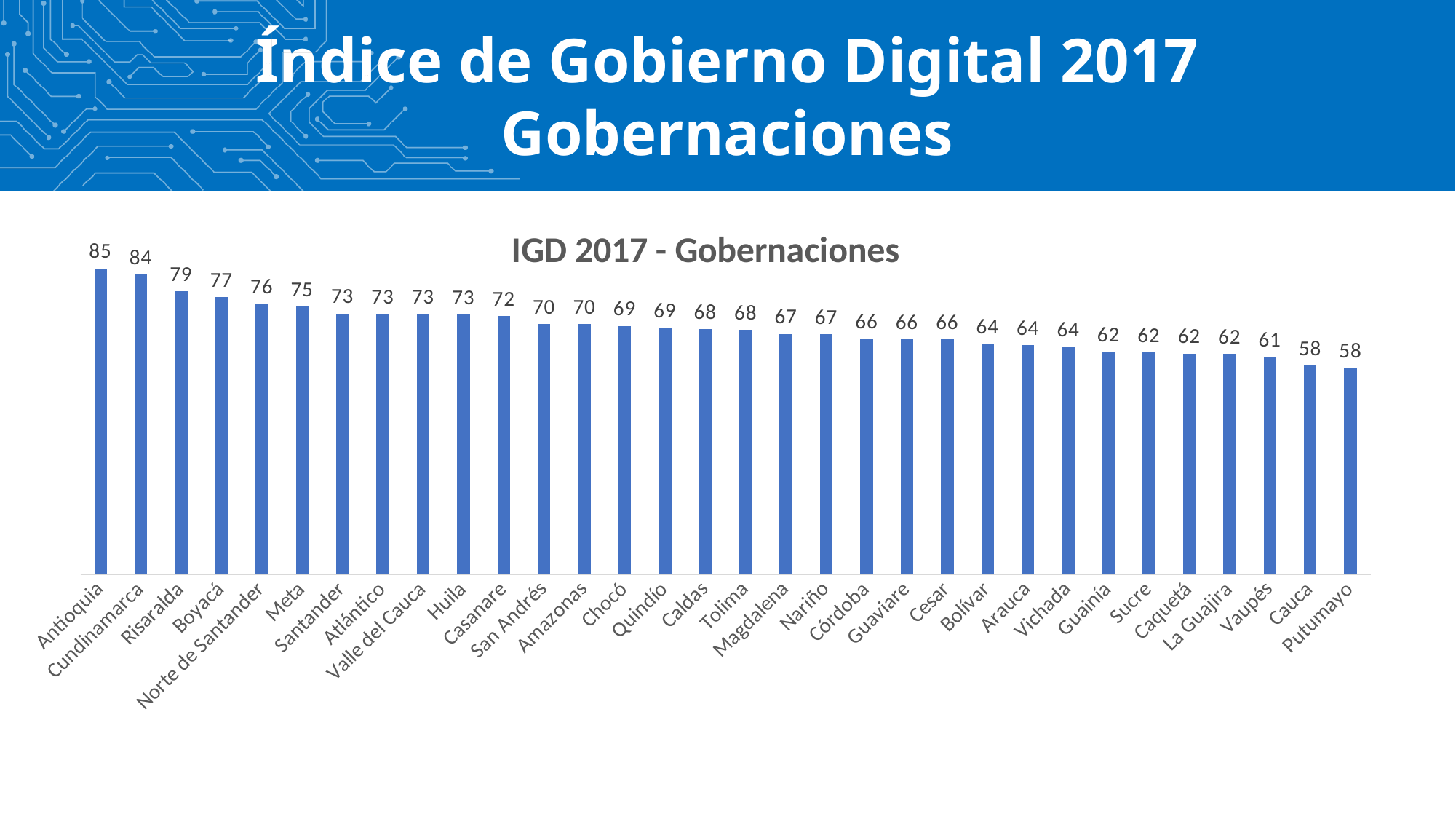
Which has a higher IGD 2017 value, Boyacá or Meta? Boyacá What is the IGD 2017 value for Antioquia? 85 What is the IGD 2017 value for Magdalena? 67 How many gobernaciones are shown in the chart? 32 What kind of chart is shown on the slide? Bar chart Do the values rise or fall from left to right along the x axis? Fall What is the difference between the IGD 2017 values of Antioquia and Cundinamarca? 1 What is the difference between the IGD 2017 values of Risaralda and Vaupés? 18 What is the lowest IGD 2017 value shown in the chart? 58 What is the IGD 2017 value for Norte de Santander? 76 What is the IGD 2017 value for Putumayo? 58 Which gobernación has the highest IGD 2017 value? Antioquia